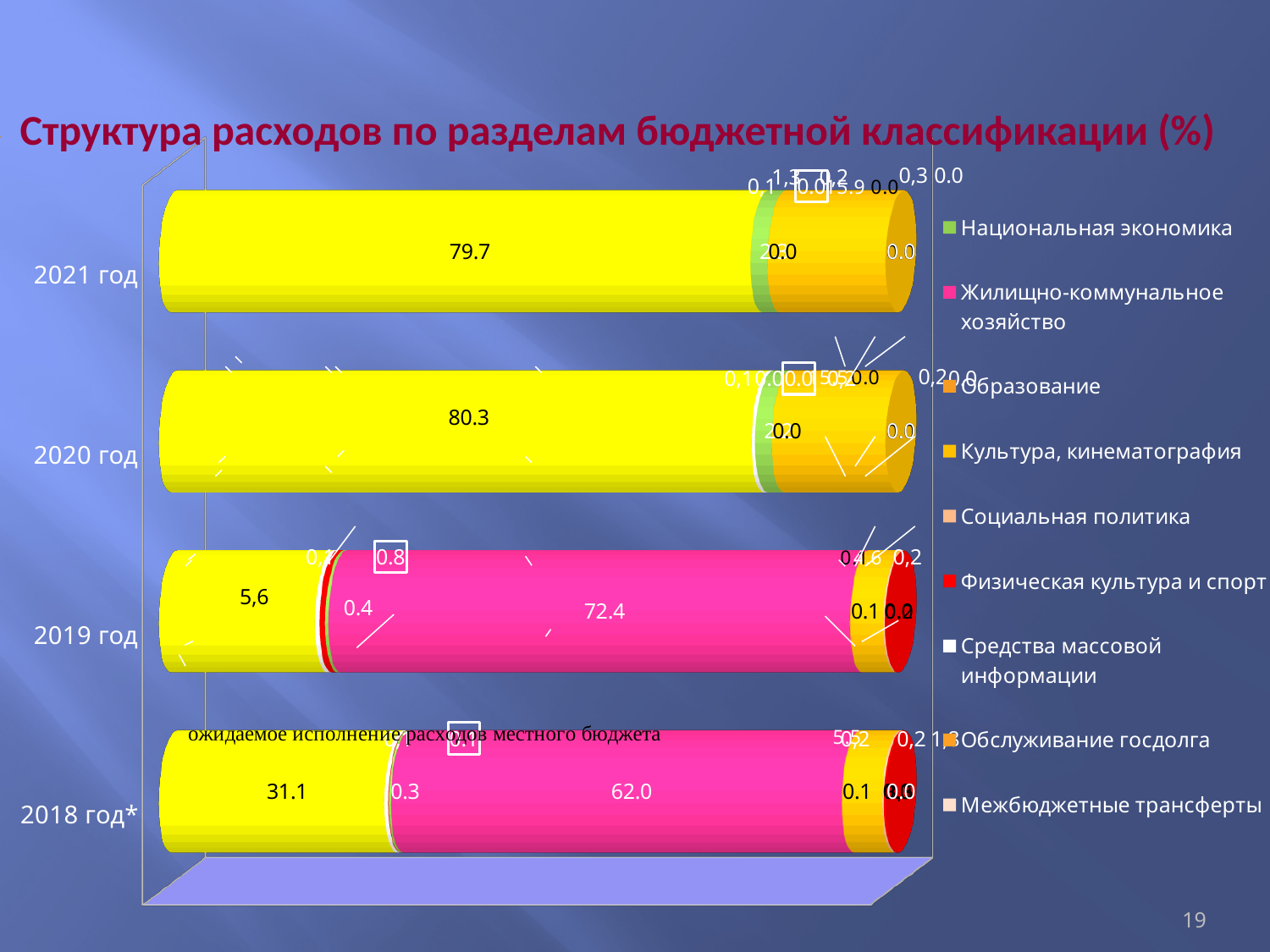
What is the value of the yellow segment for 2018 год*? 31.1 What is the title of the chart? Структура расходов по разделам бюджетной классификации (%) What is the value of the yellow segment for 2021 год? 79.7 What is the difference between the yellow segment values for 2020 год (80.3) and 2021 год (79.7)? 0.6 How many years (bars) are shown on the chart? 4 What kind of chart is shown on the slide? Stacked bar chart How many entries does the legend list? 9 What is the value of the yellow segment for 2020 год? 80.3 What is the value of the pink (Жилищно-коммунальное хозяйство) segment for 2018 год*? 62.0 Which year has the larger yellow segment, 2020 год or 2021 год? 2020 год What is the value of the pink (Жилищно-коммунальное хозяйство) segment for 2019 год? 72.4 What is the difference between the Жилищно-коммунальное хозяйство values for 2019 год (72.4) and 2018 год* (62.0)? 10.4